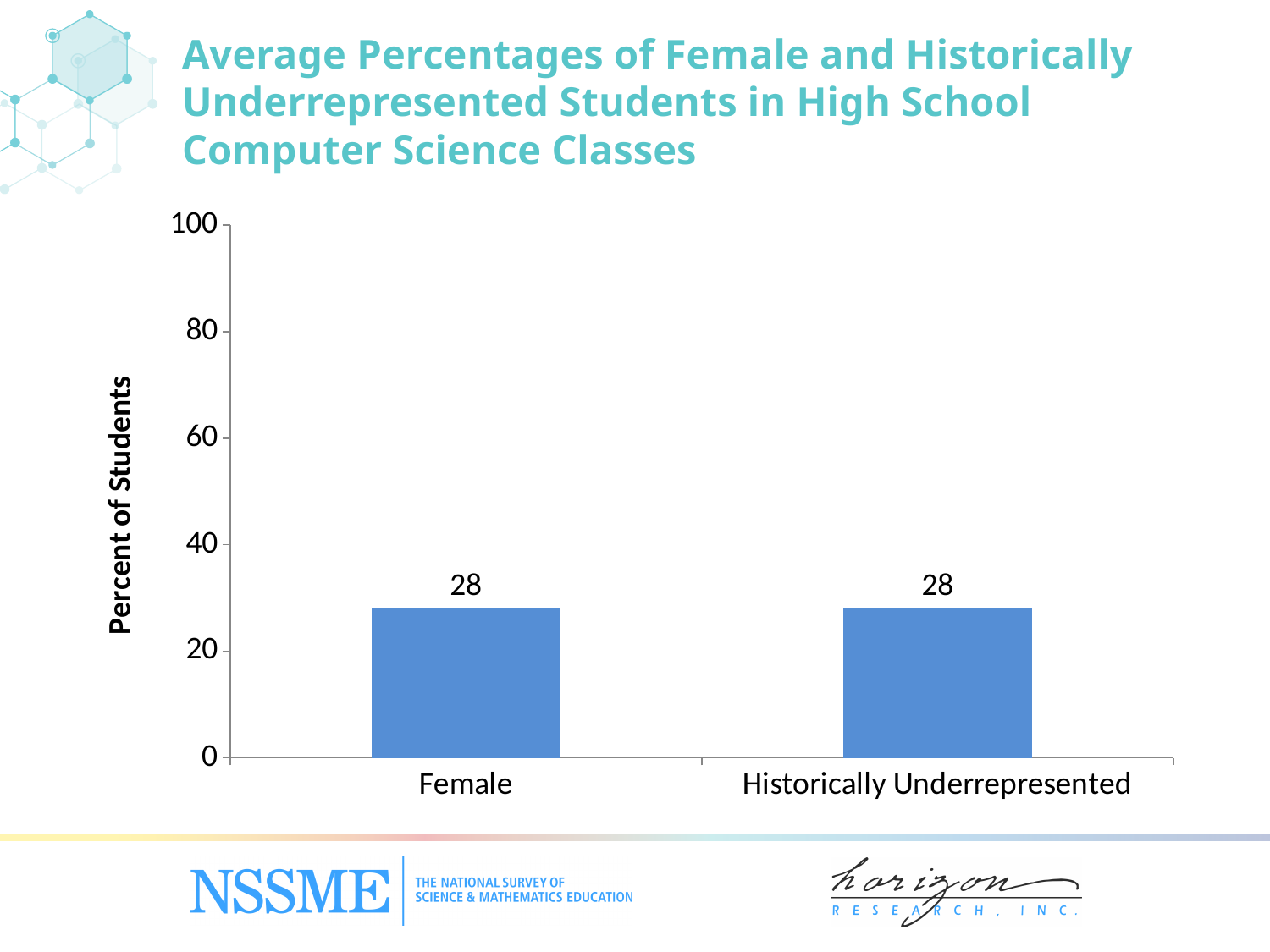
How many categories are shown on the x axis? 2 Is the value for Historically Underrepresented greater or less than 20? greater What is the label of the y axis? Percent of Students What kind of chart is shown on the slide? bar chart What is the maximum value shown on the y axis? 100 What is the value for Female? 28 What is the difference between the values for Female and Historically Underrepresented? 0 Is the value for Female greater or less than 40? less What is the value for Historically Underrepresented? 28